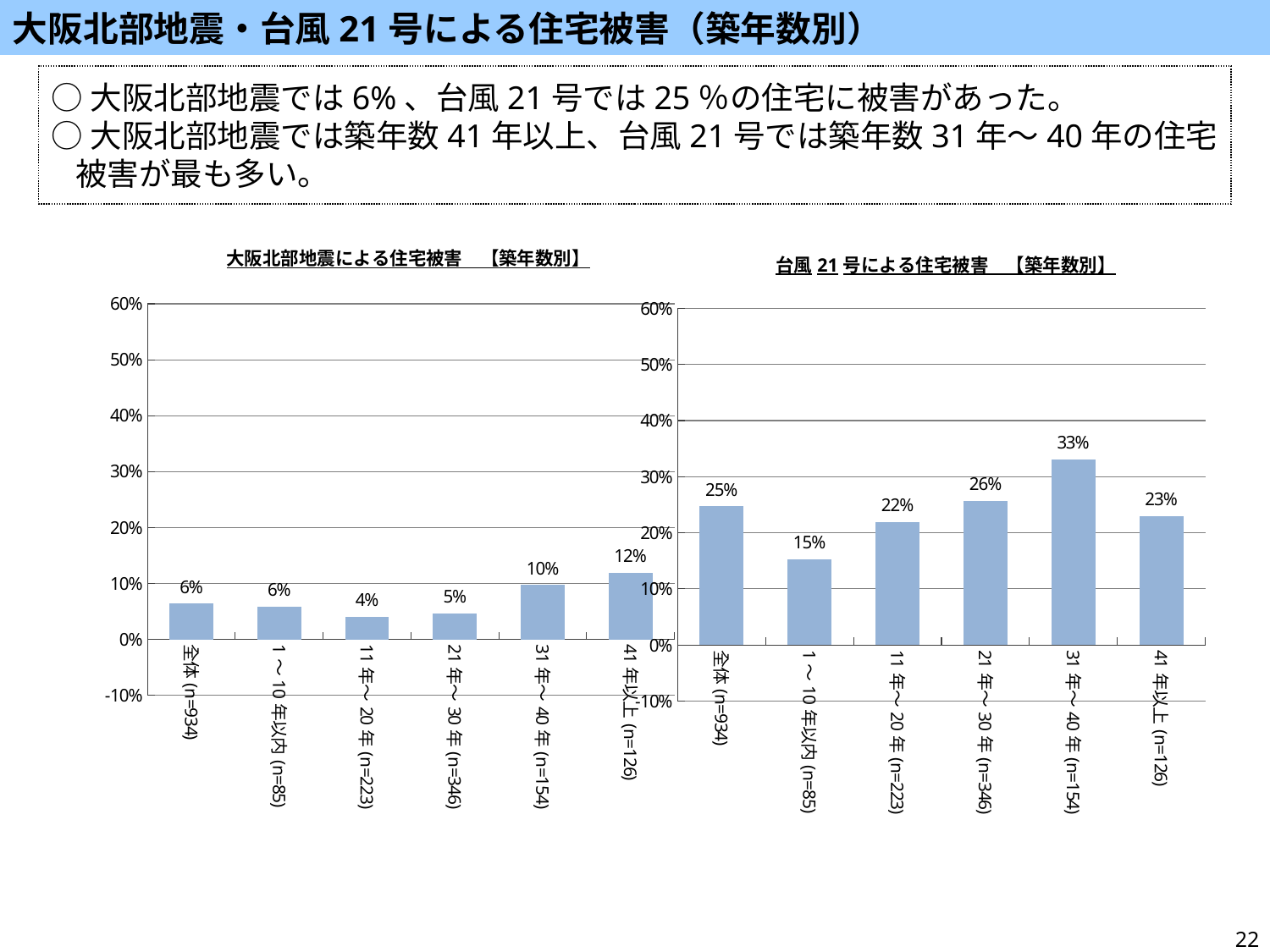
In the right chart (台風21号による住宅被害【築年数別】), what is the value for 31年～40年 (n=154)? 33% In the right chart (台風21号による住宅被害【築年数別】), which category has the lowest value? 1～10年以内 (n=85) In the left chart (大阪北部地震による住宅被害【築年数別】), what is the value for 41年以上 (n=126)? 12% In the left chart (大阪北部地震による住宅被害【築年数別】), what is the difference between the values for 41年以上 (n=126) and 全体 (n=934)? 6% In the right chart (台風21号による住宅被害【築年数別】), is the value for 31年～40年 (n=154) greater or less than 30%? greater How many categories are shown on the x axis of the left chart (大阪北部地震による住宅被害【築年数別】)? 6 In the right chart (台風21号による住宅被害【築年数別】), what is the value for 全体 (n=934)? 25% In the right chart (台風21号による住宅被害【築年数別】), what is the difference between the values for 31年～40年 (n=154) and 1～10年以内 (n=85)? 18% In the left chart (大阪北部地震による住宅被害【築年数別】), which category has the lowest value? 11年～20年 (n=223) In the right chart (台風21号による住宅被害【築年数別】), which is larger: the value for 21年～30年 (n=346) or 41年以上 (n=126)? 21年～30年 (n=346) In the left chart (大阪北部地震による住宅被害【築年数別】), which category has the highest value? 41年以上 (n=126) What kind of chart is the right chart (台風21号による住宅被害【築年数別】)? bar chart